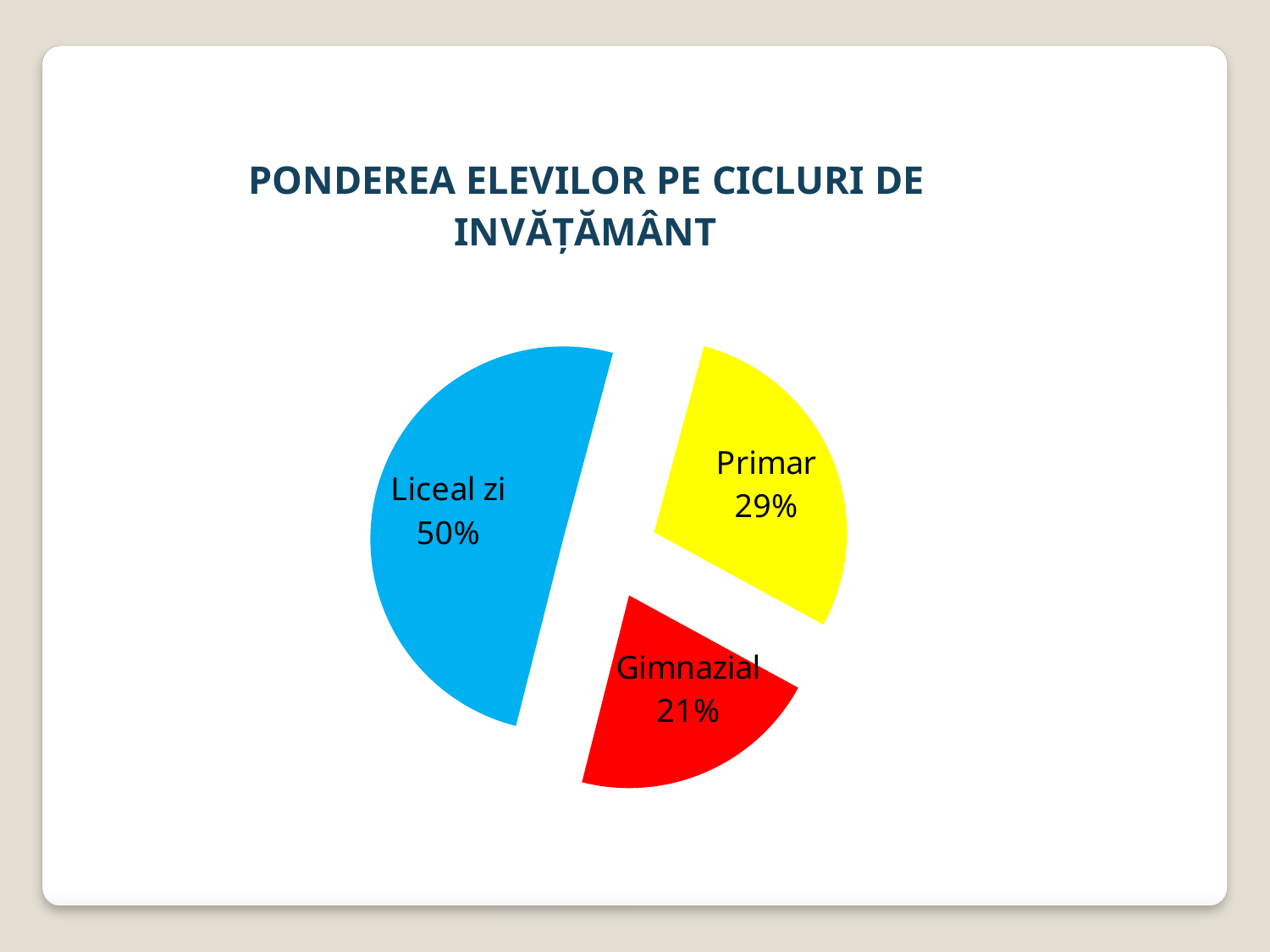
What is the difference in percentage points between Liceal zi and Primar? 21 What type of chart is shown on the slide? Pie chart What is the share for Gimnazial? 21% What is the title of the chart? PONDEREA ELEVILOR PE CICLURI DE INVĂȚĂMÂNT What colour is the Gimnazial slice? Red What is the share for Liceal zi? 50% Which is larger, the share for Primar or the share for Gimnazial? Primar What is the share for Primar? 29% How many slices does the pie chart have? 3 Which category has the smallest share of the pie? Gimnazial What is the difference in percentage points between Primar and Gimnazial? 8 Which category has the largest share of the pie? Liceal zi